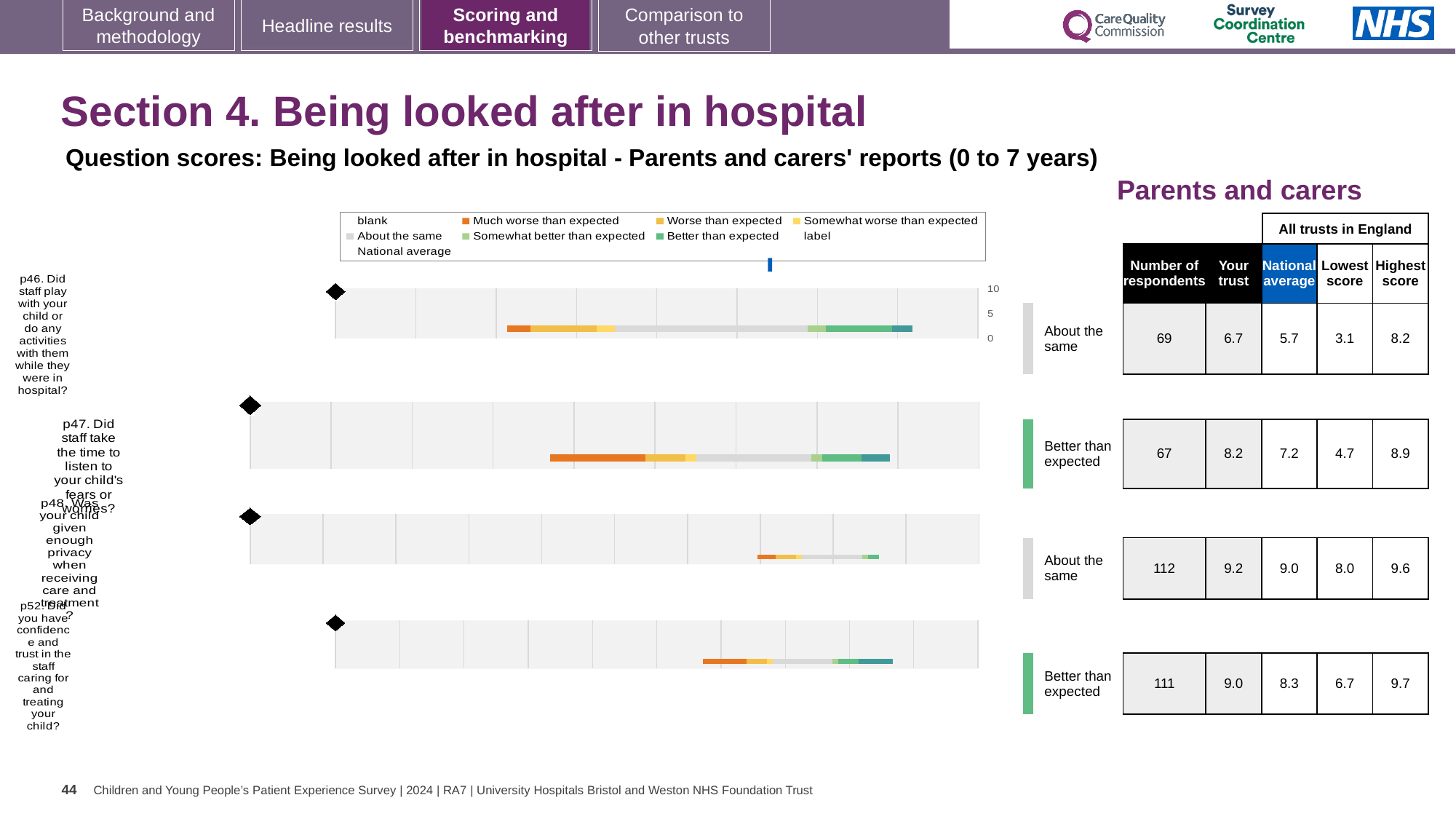
Which question has the lowest number of respondents in the table? p47 How many entries does the shared legend above the charts list? 9 In the table beside the charts, what is the highest score across all trusts in England for p52? 9.7 For p46, which is larger: the 'Your trust' score or the national average? Your trust Which question has the highest 'Your trust' score in the table? p48 For p47, what is the difference between the 'Your trust' score (8.2) and the national average (7.2)? 1.0 In the legend, what colour represents 'Much worse than expected'? orange In the table beside the charts, what is the number of respondents for p48? 112 What is the highest tick value shown on the axis of the p46 chart? 10 How many question charts (p46, p47, p48, p52) are shown on the slide? 4 In the table beside the charts, what is the 'Your trust' score for p47? 8.2 What kind of chart is used to show the score distribution for question p46? bar chart